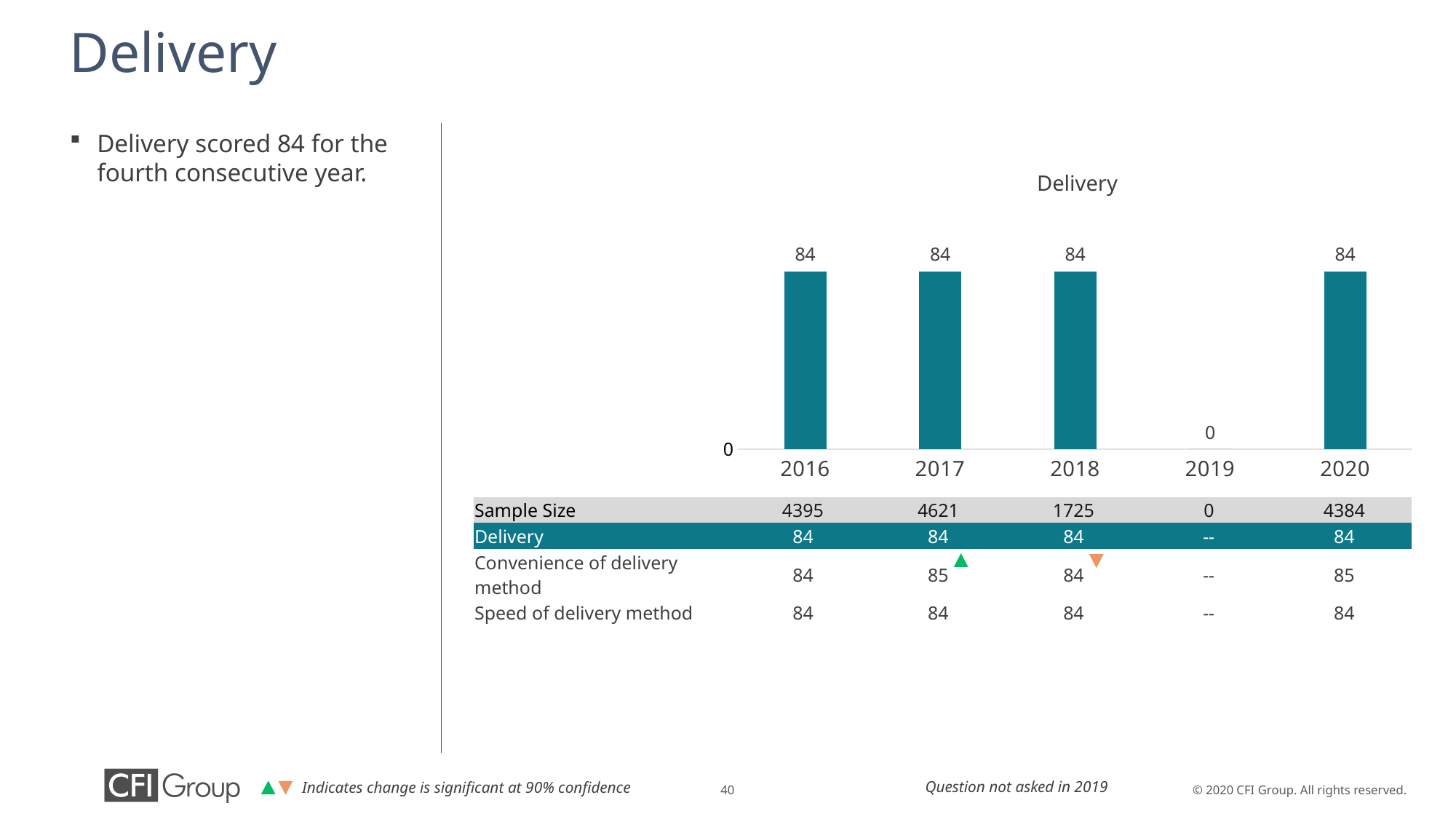
What is the difference between the Delivery scores for 2018 and 2017? 0 Is the Delivery score for 2020 larger than, smaller than, or equal to the score for 2016? equal How many years are shown on the x axis of the Delivery chart? 5 Is the Delivery score for 2017 greater or less than 0? greater What kind of chart is used to show the Delivery scores? bar chart What is the Delivery score for 2016? 84 What value is shown for 2019 in the Delivery chart? 0 Which year has the lowest value in the Delivery chart? 2019 What is the Delivery score for 2020? 84 What is the title of the chart? Delivery What colour are the bars in the Delivery chart? teal Do the Delivery scores for 2016, 2017, 2018 and 2020 rise, fall, or stay the same? stay the same